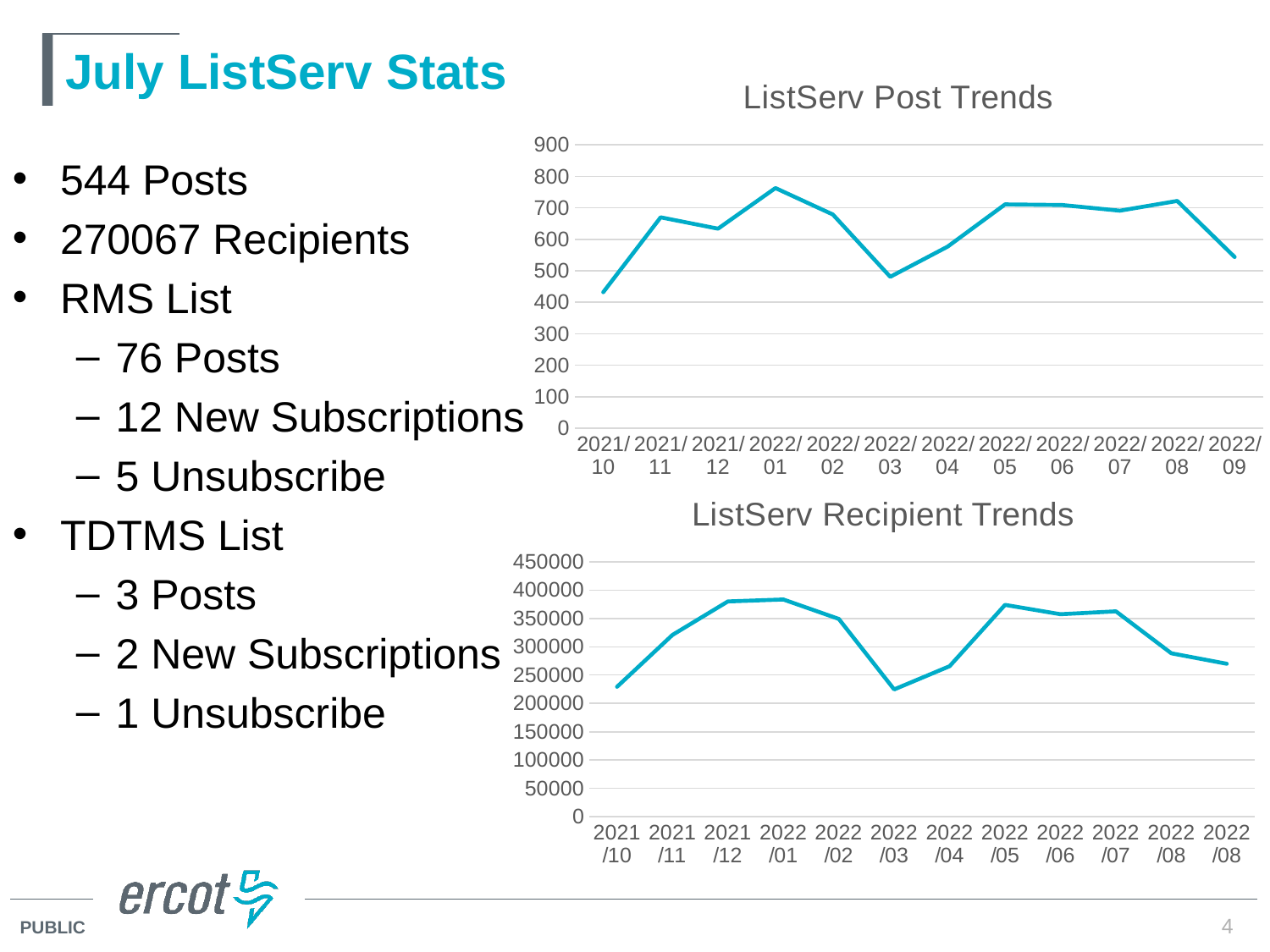
In the "ListServ Recipient Trends" chart, is the value for 2022/01 greater or less than 350000? greater In the "ListServ Recipient Trends" chart, which is larger, the value for 2021/12 or the value for 2022/03? 2021/12 In the "ListServ Post Trends" chart, which month has the lowest number of posts? 2021/10 What kind of chart is the "ListServ Post Trends" chart? line chart In the "ListServ Recipient Trends" chart, is the value for 2022/03 greater or less than 250000? less In the "ListServ Post Trends" chart, which month has the highest number of posts? 2022/01 In the "ListServ Post Trends" chart, is the value for 2022/03 greater or less than 500? less In the "ListServ Post Trends" chart, do the values rise or fall from 2022/03 to 2022/05? rise In the "ListServ Post Trends" chart, how many months are plotted along the x axis? 12 What kind of chart is the "ListServ Recipient Trends" chart? line chart In the "ListServ Recipient Trends" chart, do the values rise or fall from 2022/01 to 2022/03? fall